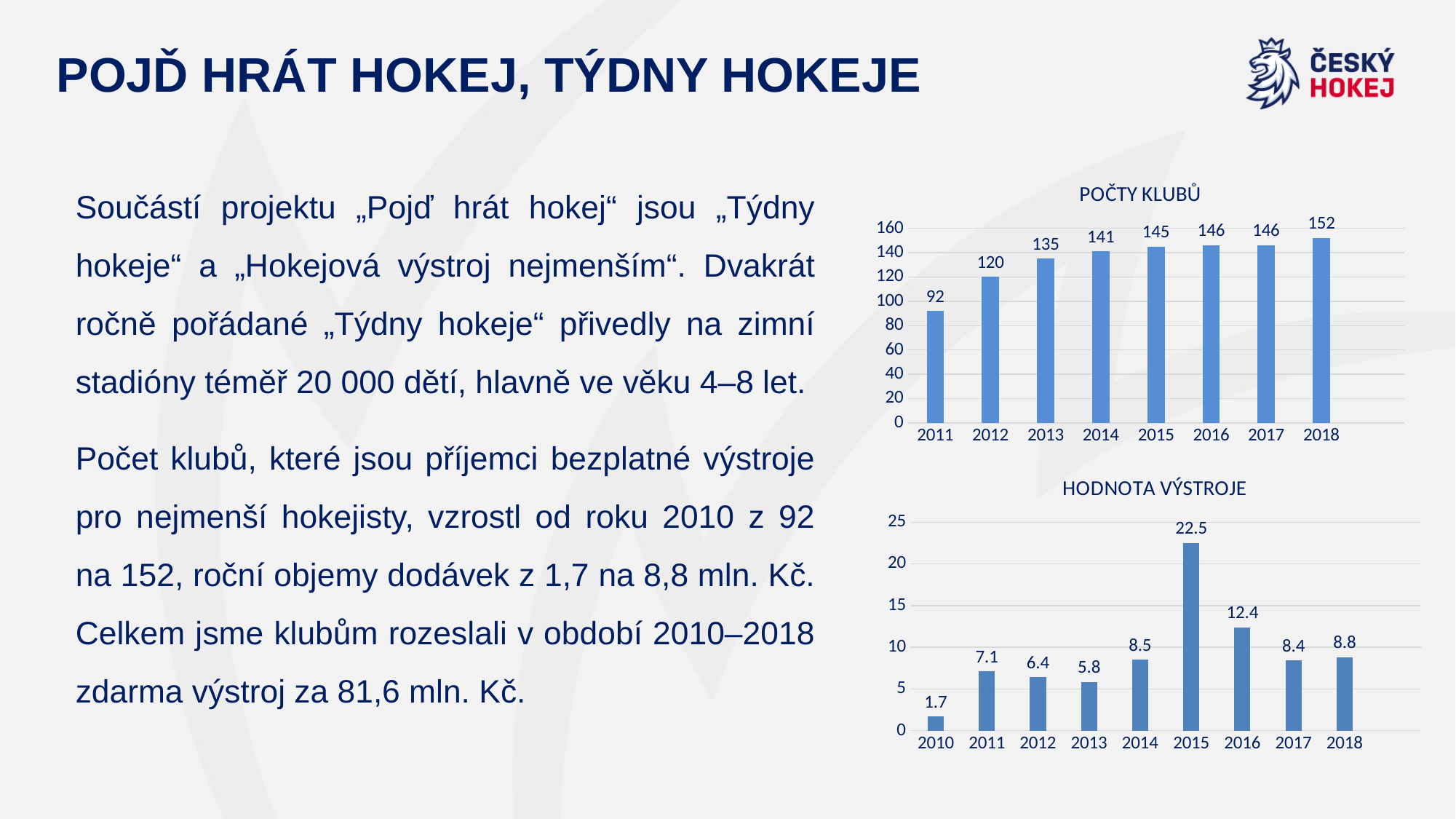
What type of chart is the HODNOTA VÝSTROJE chart? bar chart In the POČTY KLUBŮ chart, which year has the lowest value? 2011 In the POČTY KLUBŮ chart, how many years are shown on the x axis? 8 In the HODNOTA VÝSTROJE chart, what is the value for 2016? 12.4 In the HODNOTA VÝSTROJE chart, what is the difference between the values for 2015 and 2016? 10.1 In the POČTY KLUBŮ chart, which year has the highest value? 2018 In the POČTY KLUBŮ chart, what is the difference between the values for 2018 and 2011? 60 In the POČTY KLUBŮ chart, what is the value for 2013? 135 In the HODNOTA VÝSTROJE chart, which year has the lowest value? 2010 In the HODNOTA VÝSTROJE chart, which is larger, the value for 2011 or the value for 2013? 2011 In the HODNOTA VÝSTROJE chart, which year has the highest value? 2015 In the POČTY KLUBŮ chart, do the values rise or fall from 2011 to 2018? rise